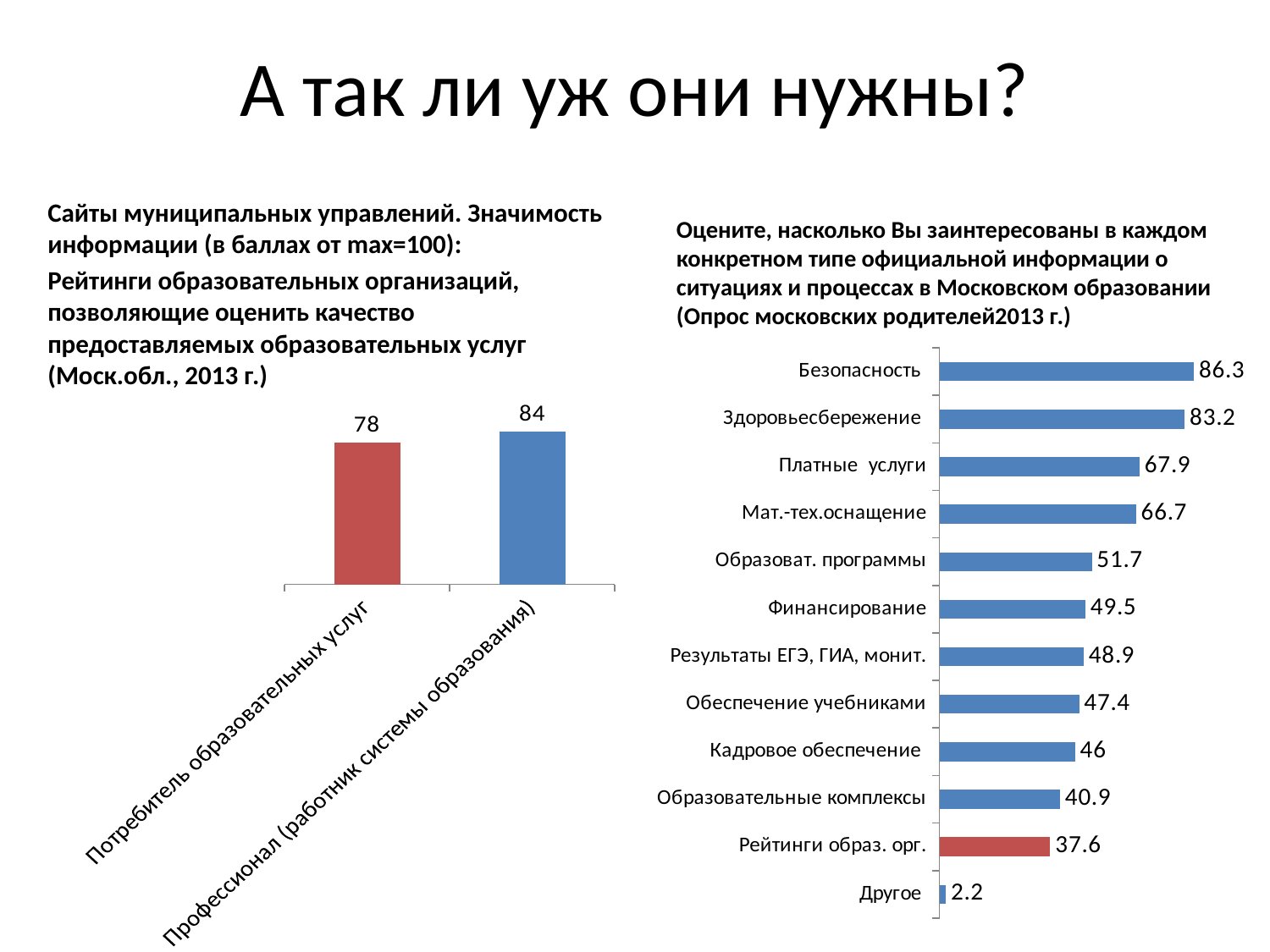
In the right chart, which category has the lowest value? Другое In the left chart, which category has the higher value, Потребитель образовательных услуг or Профессионал? Профессионал (работник системы образования) In the right chart, which category has the highest value? Безопасность In the right chart, what is the difference between the values for Безопасность and Здоровьесбережение? 3.1 In the left chart, what is the value for Профессионал (работник системы образования)? 84 In the left chart, what is the difference between the values for Профессионал and Потребитель образовательных услуг? 6 In the right chart, which bar is coloured red instead of blue? Рейтинги образ. орг. What kind of chart is the right chart? Bar chart In the right chart, what is the value for Безопасность? 86.3 In the left chart, what is the value for Потребитель образовательных услуг? 78 In the right chart, what is the value for Рейтинги образ. орг.? 37.6 In the right chart, how many categories are shown? 12